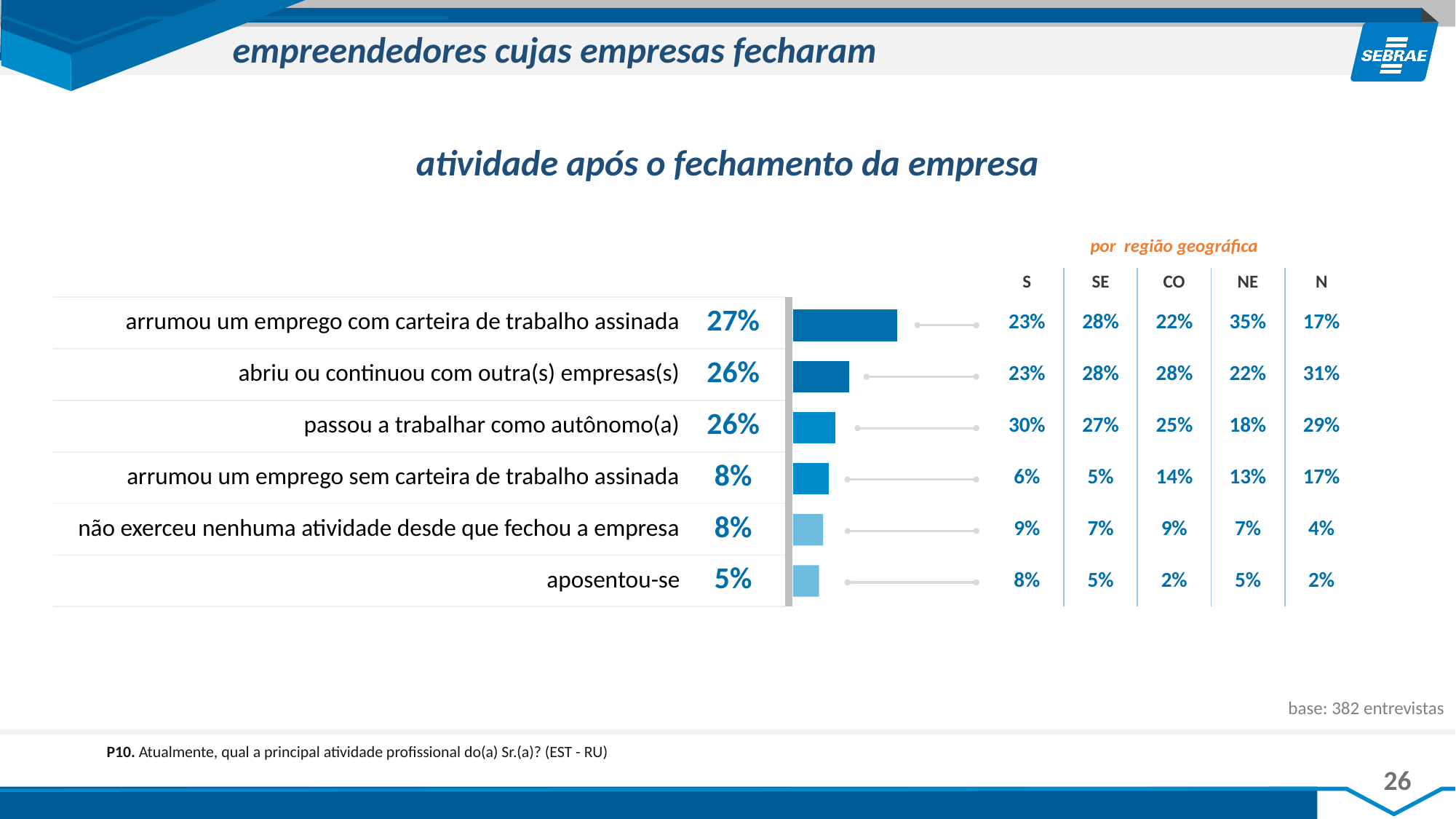
Which is larger: "abriu ou continuou com outra(s) empresas(s)" or "arrumou um emprego sem carteira de trabalho assinada"? abriu ou continuou com outra(s) empresas(s) What is the value for "aposentou-se"? 5% What is the title of the chart? atividade após o fechamento da empresa Which category has the highest value? arrumou um emprego com carteira de trabalho assinada What kind of chart is shown on the slide? bar chart What is the value for "passou a trabalhar como autônomo(a)"? 26% How many categories does the bar chart show? 6 Which category has the lowest value? aposentou-se What is the value for "arrumou um emprego com carteira de trabalho assinada"? 27% In the regional table, what is the value for "aposentou-se" in region S? 8% What is the difference between "arrumou um emprego com carteira de trabalho assinada" and "aposentou-se"? 22% In the regional table, what is the value for "arrumou um emprego com carteira de trabalho assinada" in region NE? 35%